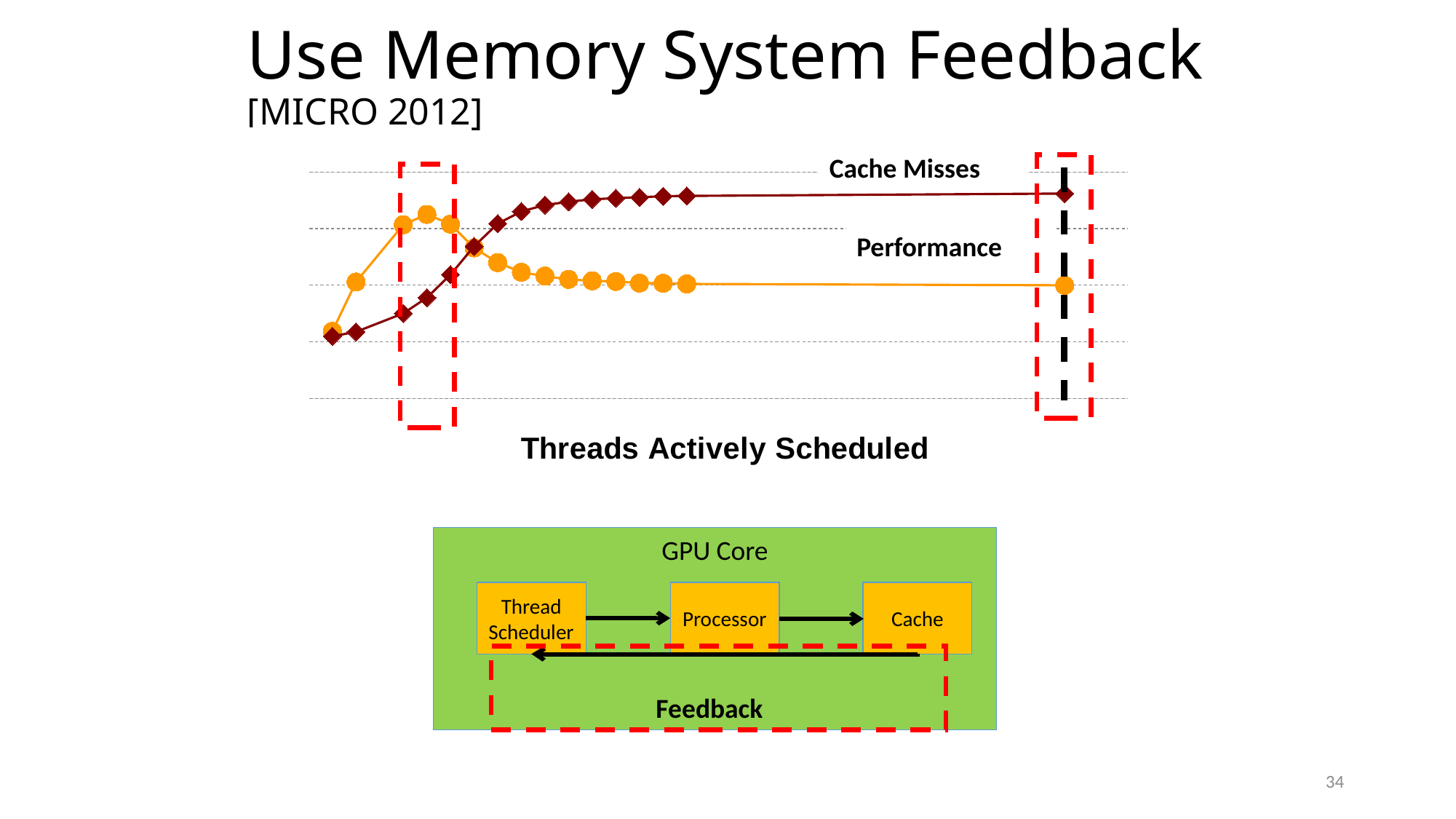
What kind of chart is shown on the slide? line chart What are the names of the two series plotted in the chart? Cache Misses and Performance What is the label of the x axis of the chart? Threads Actively Scheduled Which series reaches its peak at a smaller number of threads actively scheduled, Cache Misses or Performance? Performance At the rightmost point of the chart, which series is higher, Cache Misses or Performance? Cache Misses Does the Cache Misses series rise or fall as the number of threads actively scheduled increases from the left? rises How many series are plotted in the chart? 2 After reaching its peak, does the Performance series rise or fall as more threads are actively scheduled? falls